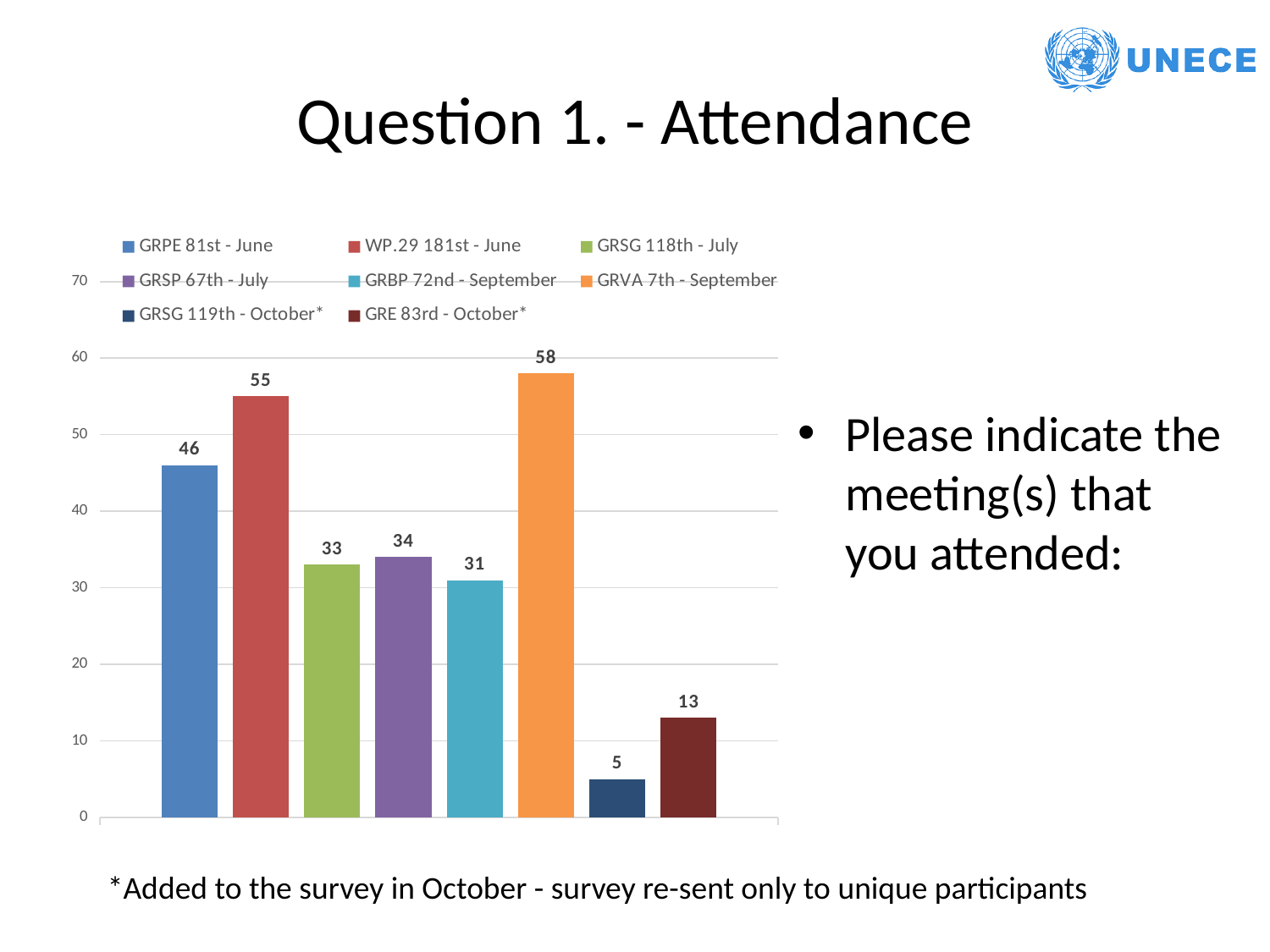
What is the attendance value for GRVA 7th - September? 58 Which meeting has the lowest attendance? GRSG 119th - October* What is the difference between the attendance for WP.29 181st - June and GRPE 81st - June? 9 What is the attendance value for GRSG 119th - October*? 5 Which meeting has the highest attendance? GRVA 7th - September What kind of chart is shown on the slide? bar chart Is the value for GRPE 81st - June greater or less than 40? greater What is the title of the slide containing the chart? Question 1. - Attendance Which has a higher attendance value, GRSP 67th - July or GRE 83rd - October*? GRSP 67th - July How many bars are plotted in the chart? 8 What is the attendance value for GRBP 72nd - September? 31 How many series does the legend list? 8